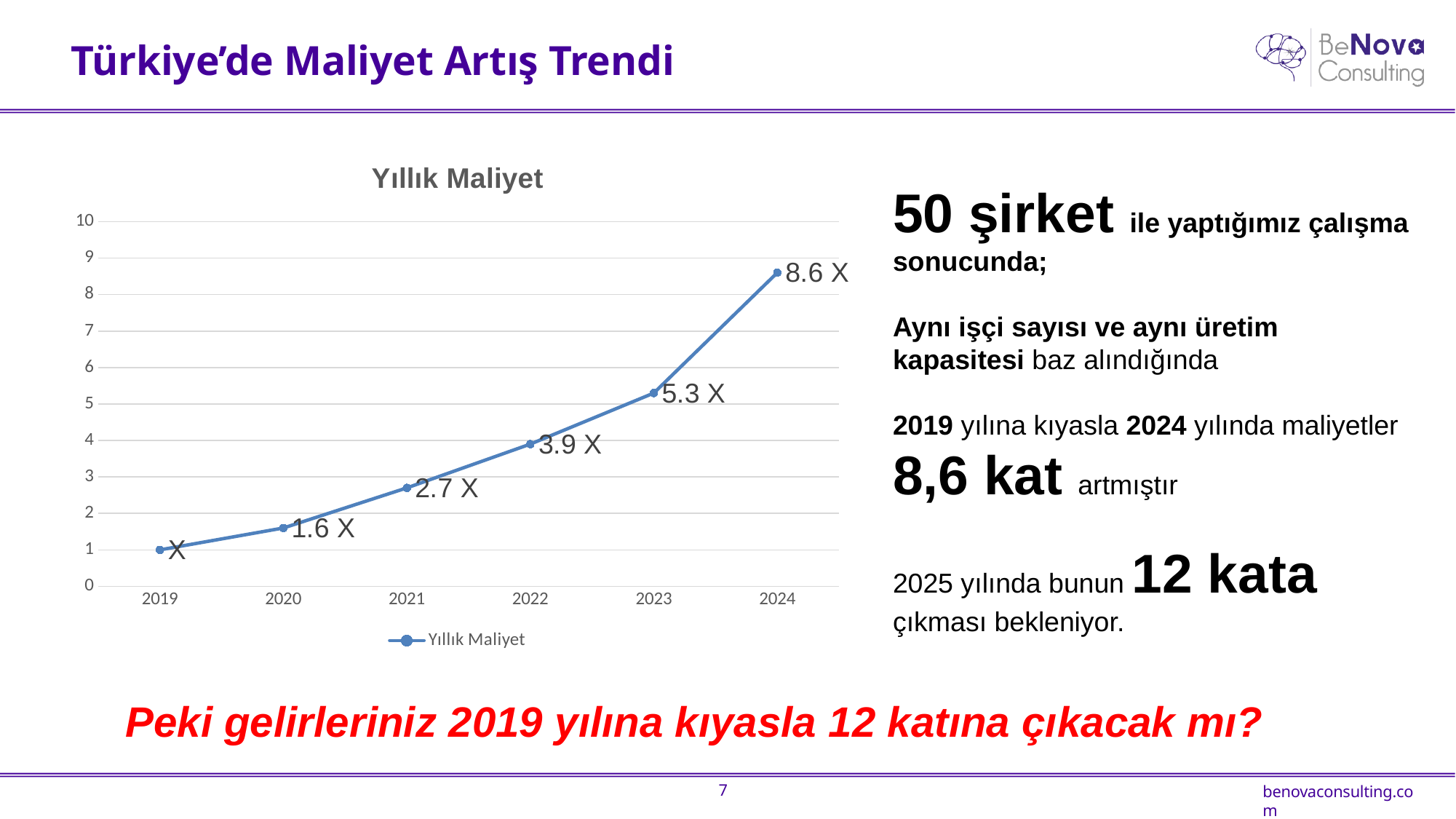
Which is larger in the Yıllık Maliyet chart, the value for 2020 or the value for 2022? 2022 How many years are plotted on the x axis of the Yıllık Maliyet chart? 6 What is the value for 2021 in the Yıllık Maliyet chart? 2.7 X Which year has the lowest value in the Yıllık Maliyet chart? 2019 Is the value for 2019 in the Yıllık Maliyet chart greater or less than 2? less What kind of chart is the Yıllık Maliyet chart? line chart Do the values in the Yıllık Maliyet chart rise or fall from 2019 to 2024? rise What is the value for 2024 in the Yıllık Maliyet chart? 8.6 X What is the difference between the 2024 and 2023 values in the Yıllık Maliyet chart? 3.3 X What is the value for 2023 in the Yıllık Maliyet chart? 5.3 X How many series does the legend of the Yıllık Maliyet chart list? 1 Which year has the highest value in the Yıllık Maliyet chart? 2024